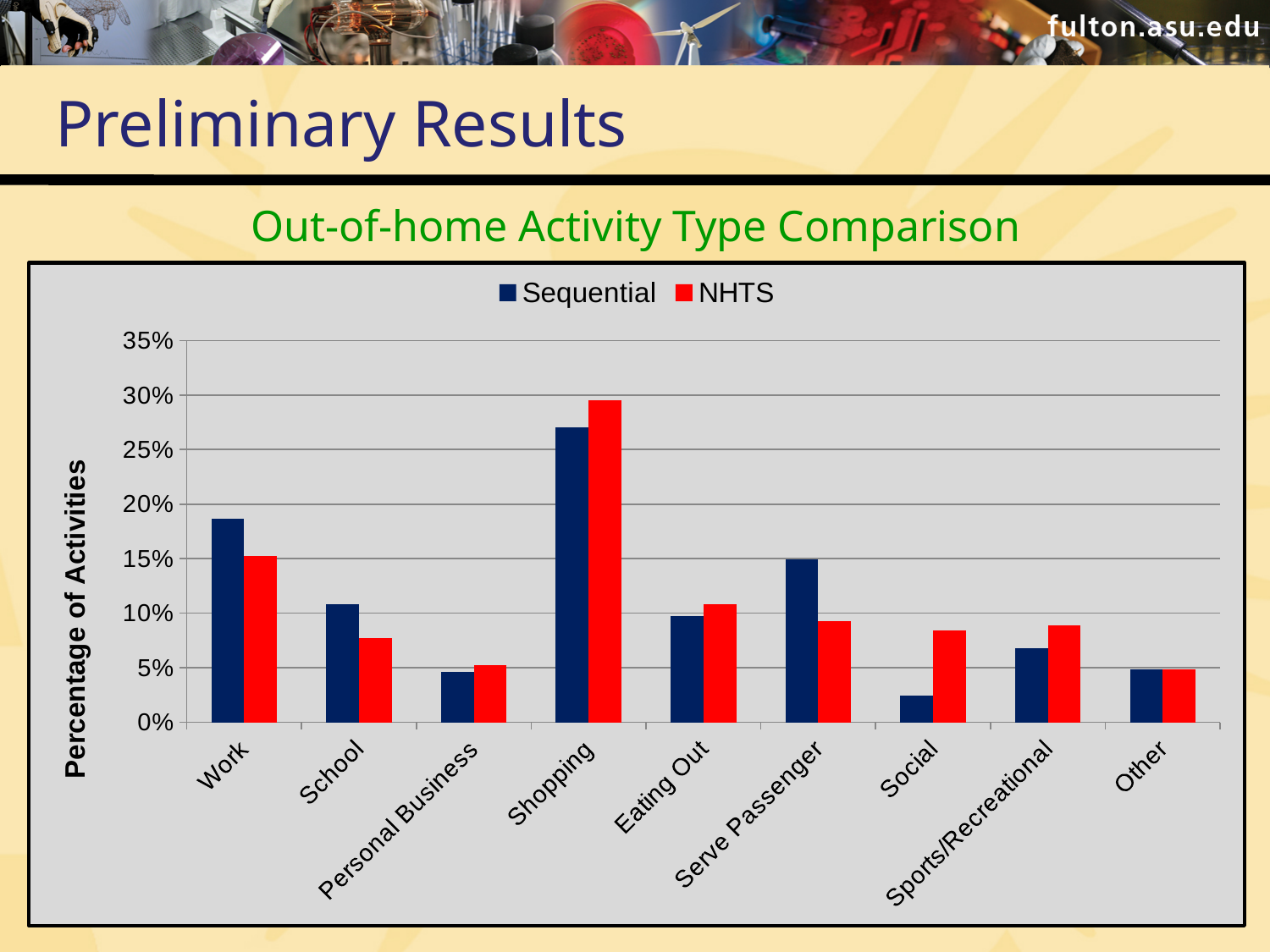
What is the title of the y axis? Percentage of Activities Which activity type has the lowest Sequential value? Social What kind of chart is shown on the slide? bar chart Is the Sequential value for Social greater or less than 5%? less For Social, which series has the larger value, Sequential or NHTS? NHTS How many activity categories are shown on the x axis? 9 For Serve Passenger, which series has the larger value, Sequential or NHTS? Sequential Which activity type has the highest NHTS value? Shopping For Work, which series has the larger value, Sequential or NHTS? Sequential Which activity type has the highest Sequential value? Shopping How many series does the legend list? 2 Is the Sequential value for Shopping greater or less than 25%? greater